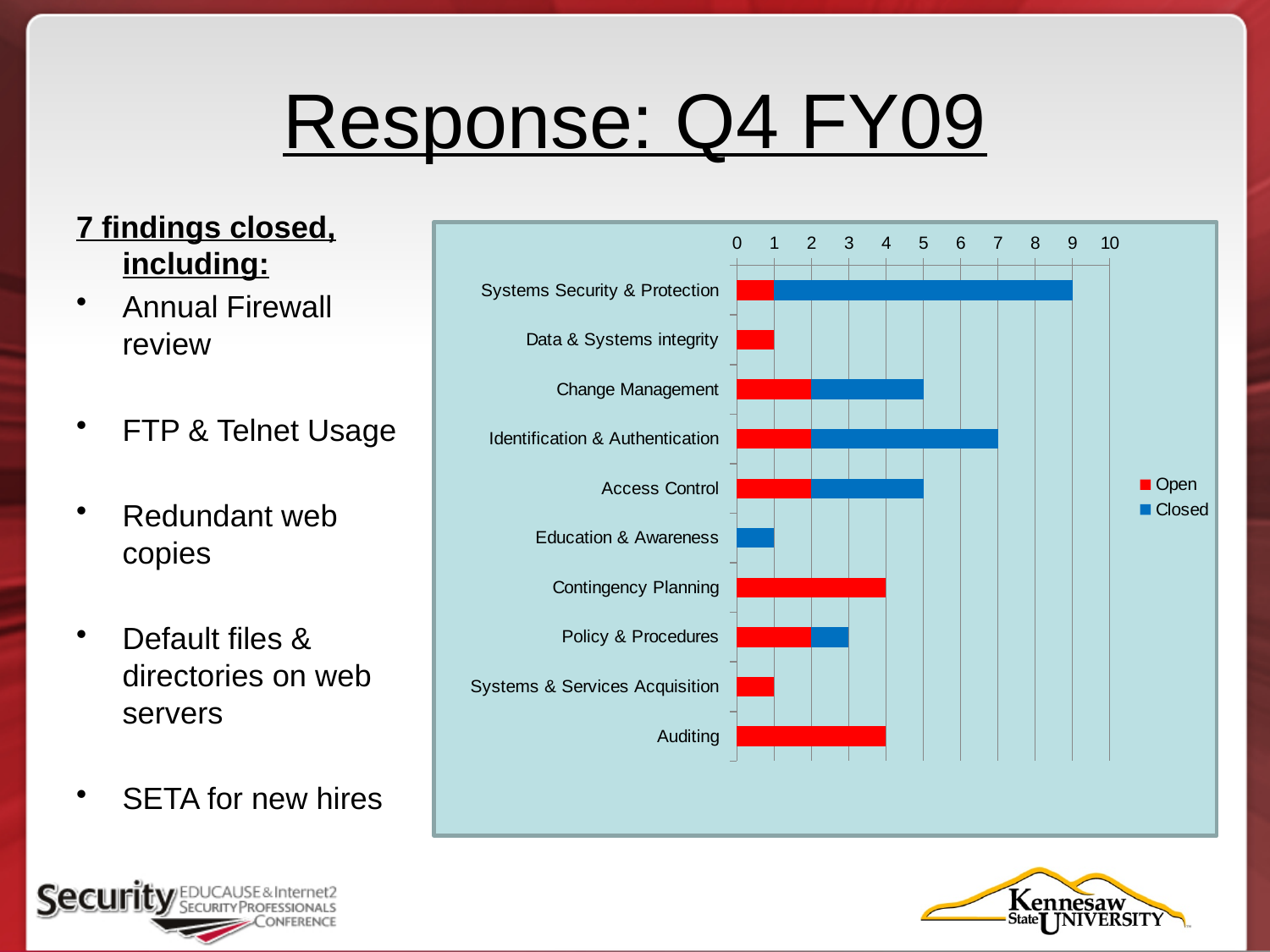
What is the total length of the stacked bar for Identification & Authentication? 7 Which legend entry is shown in red? Open Which has a longer total bar, Identification & Authentication or Change Management? Identification & Authentication How many series does the chart legend list? 2 Which category has the longest total bar on the chart? Systems Security & Protection What is the total length of the stacked bar for Systems Security & Protection? 9 What kind of chart is shown on the slide? Stacked bar chart How many categories are plotted on the chart? 10 What is the Open value for Change Management? 2 What is the Open value for Auditing? 4 Is the total bar for Systems Security & Protection greater or less than 5? greater What is the Open value for Contingency Planning? 4